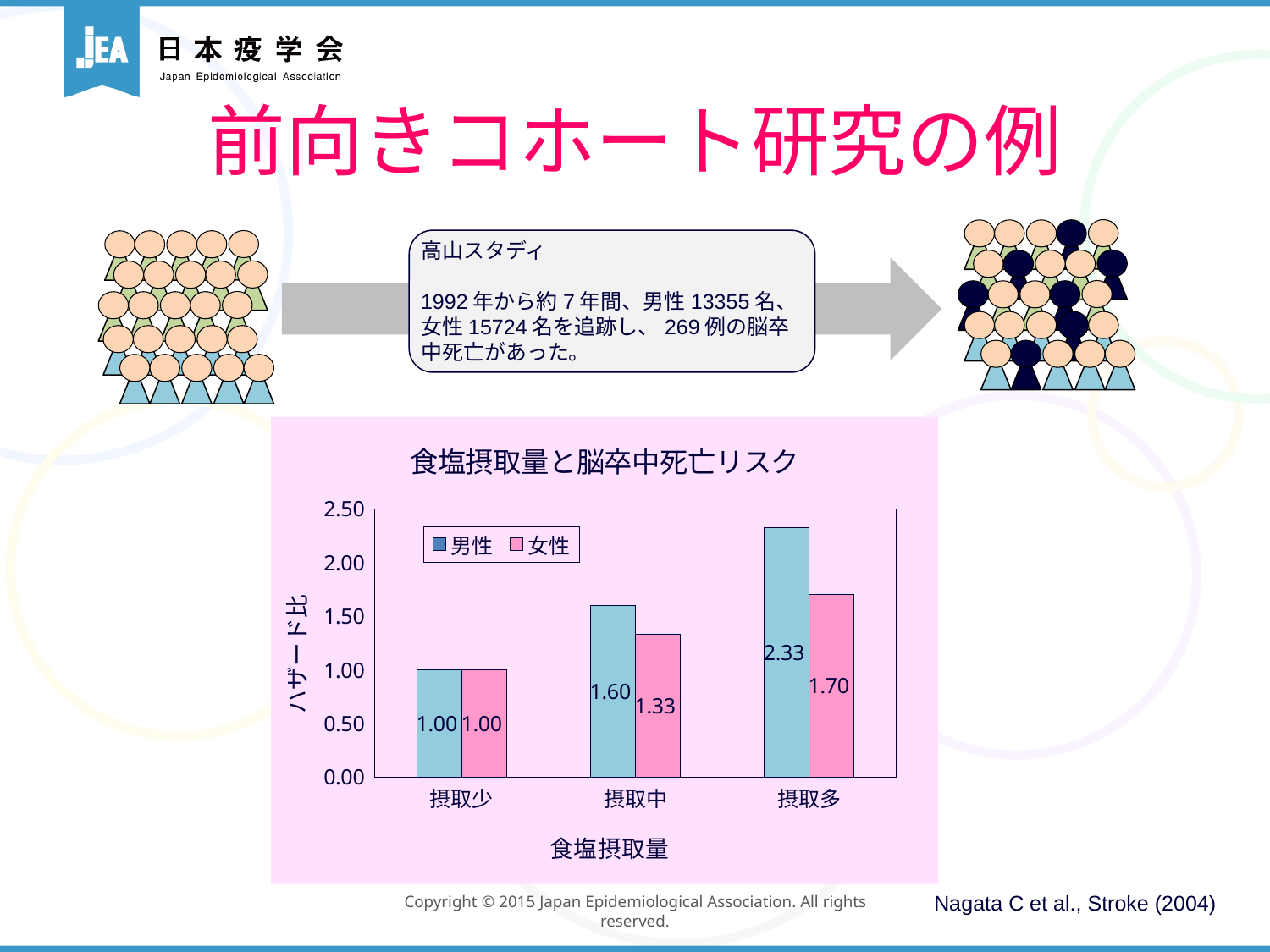
Is the hazard ratio for 男性 in the 摂取多 category greater or less than 2.00? greater How many salt intake categories are shown on the x axis? 3 What is the difference between the 男性 and 女性 hazard ratios in the 摂取多 category? 0.63 What kind of chart is shown on the slide? bar chart Do the hazard ratios for 女性 rise or fall as salt intake increases from 摂取少 to 摂取多? rise What is the hazard ratio for 男性 in the 摂取少 category? 1.00 Which salt intake category has the lowest hazard ratio for 女性? 摂取少 In the 摂取中 category, which series has the larger hazard ratio, 男性 or 女性? 男性 How many series does the legend list? 2 Which salt intake category has the highest hazard ratio for 男性? 摂取多 What is the hazard ratio for 男性 in the 摂取多 category? 2.33 What is the hazard ratio for 女性 in the 摂取中 category? 1.33